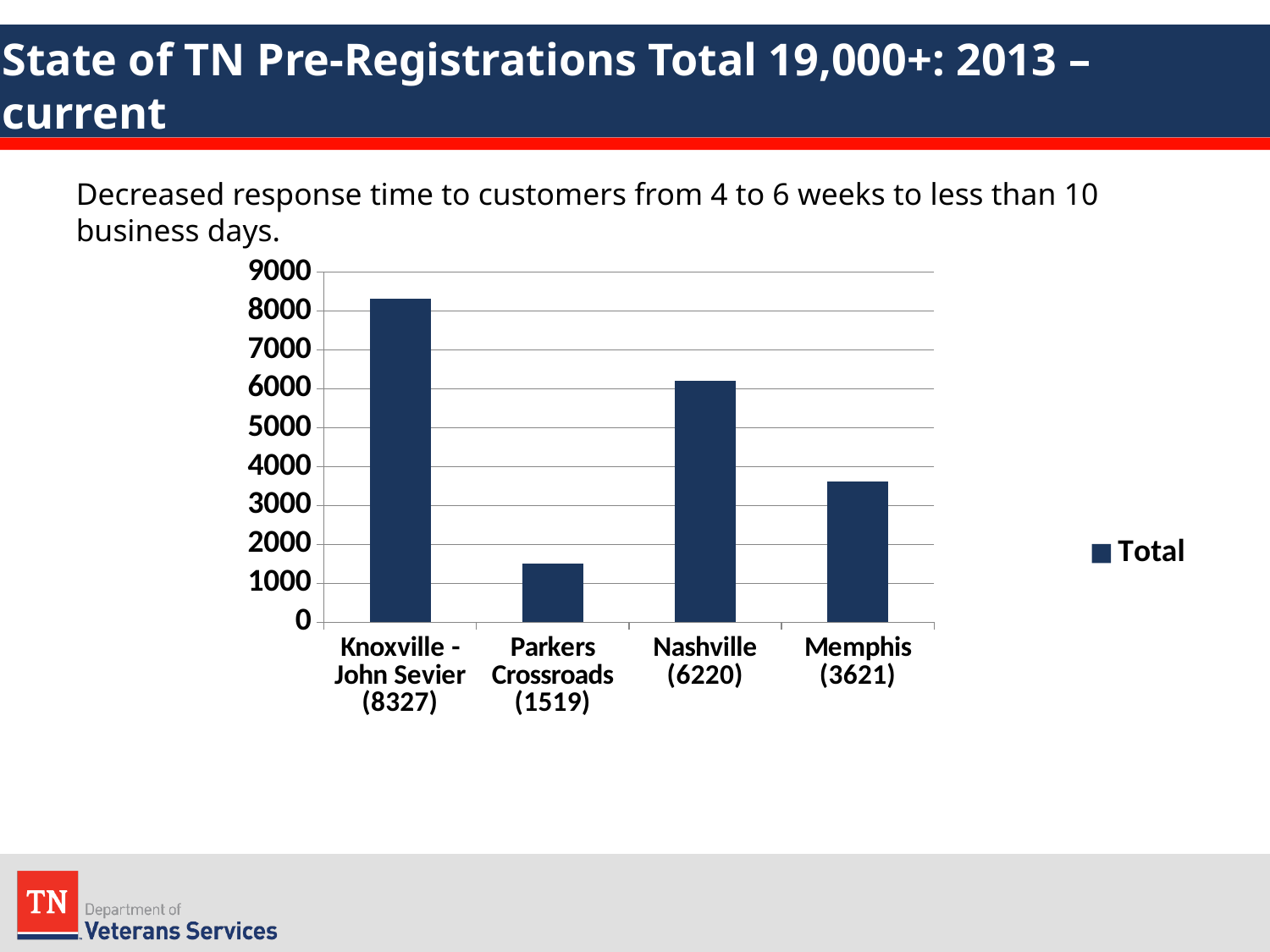
What kind of chart is shown on the slide? Bar chart Which location has the lowest total? Parkers Crossroads How many locations are shown in the chart? 4 How many series does the legend list? 1 What is the total for Nashville? 6220 What is the total for Knoxville - John Sevier? 8327 Which has a larger total, Nashville or Memphis? Nashville Is the value for Memphis greater or less than 4000? less What is the total for Parkers Crossroads? 1519 What is the total for Memphis? 3621 What is the difference between the totals for Knoxville - John Sevier and Nashville? 2107 Which location has the highest total? Knoxville - John Sevier